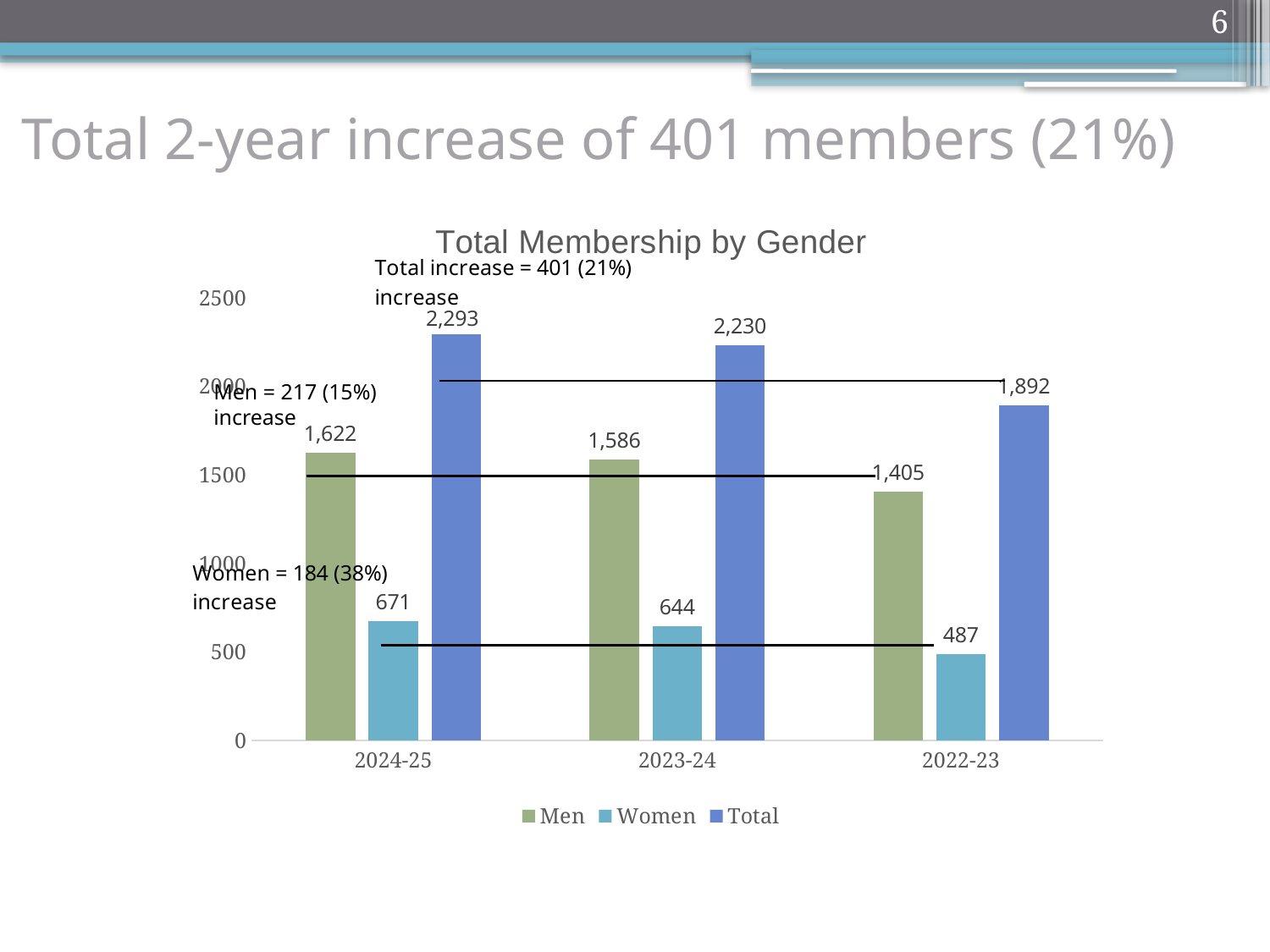
Which year has the lowest value for Women? 2022-23 Which year has the highest Total value? 2024-25 What is the value for Women in 2022-23? 487 What kind of chart is shown on the slide? Bar chart What is the title of the chart? Total Membership by Gender How many year categories are shown on the x axis? 3 What is the difference between the Men values for 2023-24 and 2022-23? 181 What is the value for Men in 2024-25? 1,622 What is the difference between the Total values for 2024-25 and 2022-23? 401 How many series does the legend list? 3 Which is larger, the Women value for 2024-25 or the Women value for 2023-24? 2024-25 What is the Total value for 2023-24? 2,230